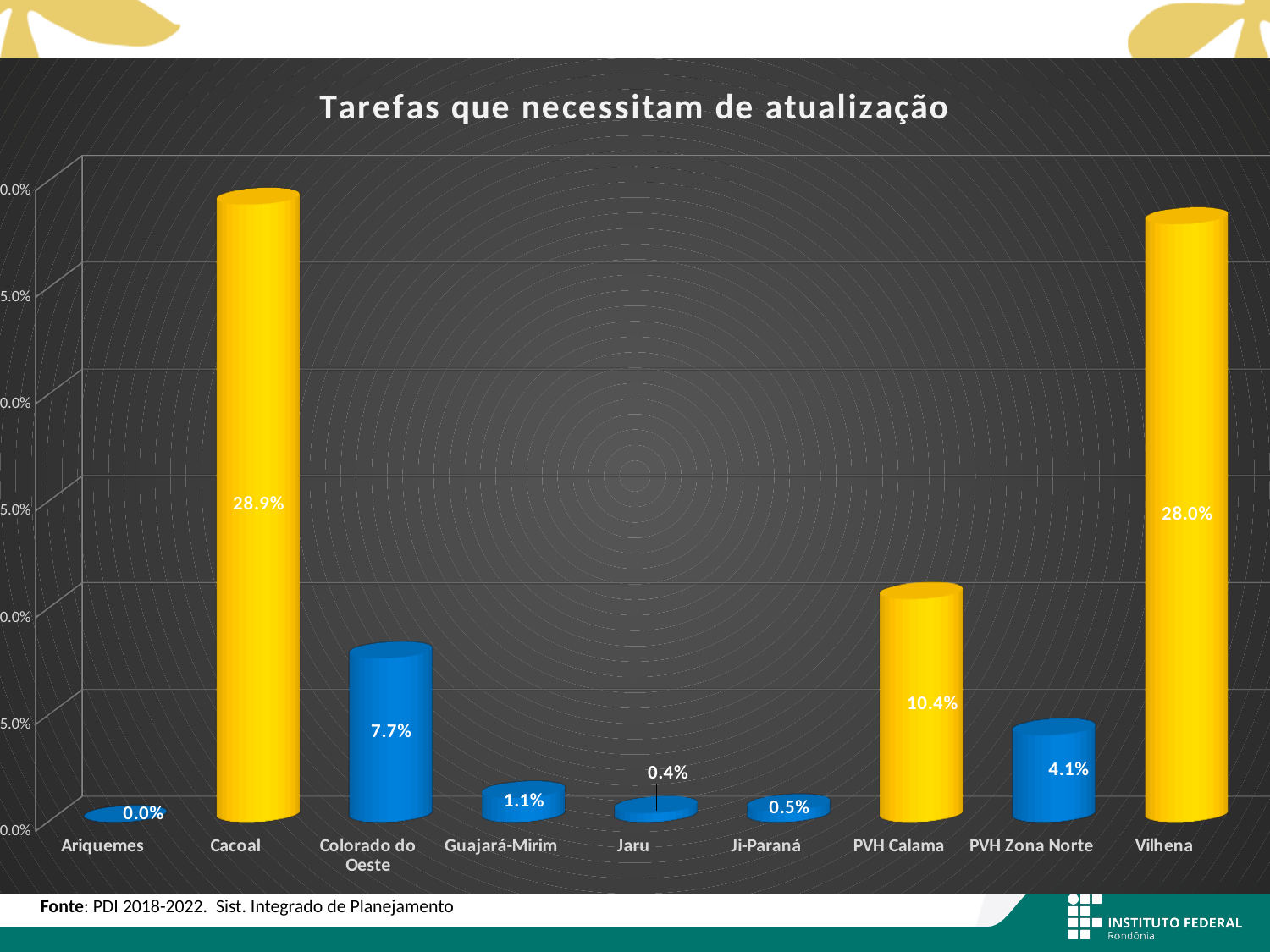
What is the title of the chart? Tarefas que necessitam de atualização What kind of chart is this? Bar chart What is the difference between the values for PVH Calama and Colorado do Oeste? 2.7% Which is larger, the value for PVH Zona Norte or the value for Guajará-Mirim? PVH Zona Norte Which category has the lowest value? Ariquemes Which category has the highest value? Cacoal What is the difference between the values for Cacoal and Vilhena? 0.9% How many categories are shown on the x axis? 9 What is the value for Cacoal? 28.9% What is the value for Colorado do Oeste? 7.7% What is the value for PVH Calama? 10.4% What is the value for Jaru? 0.4%